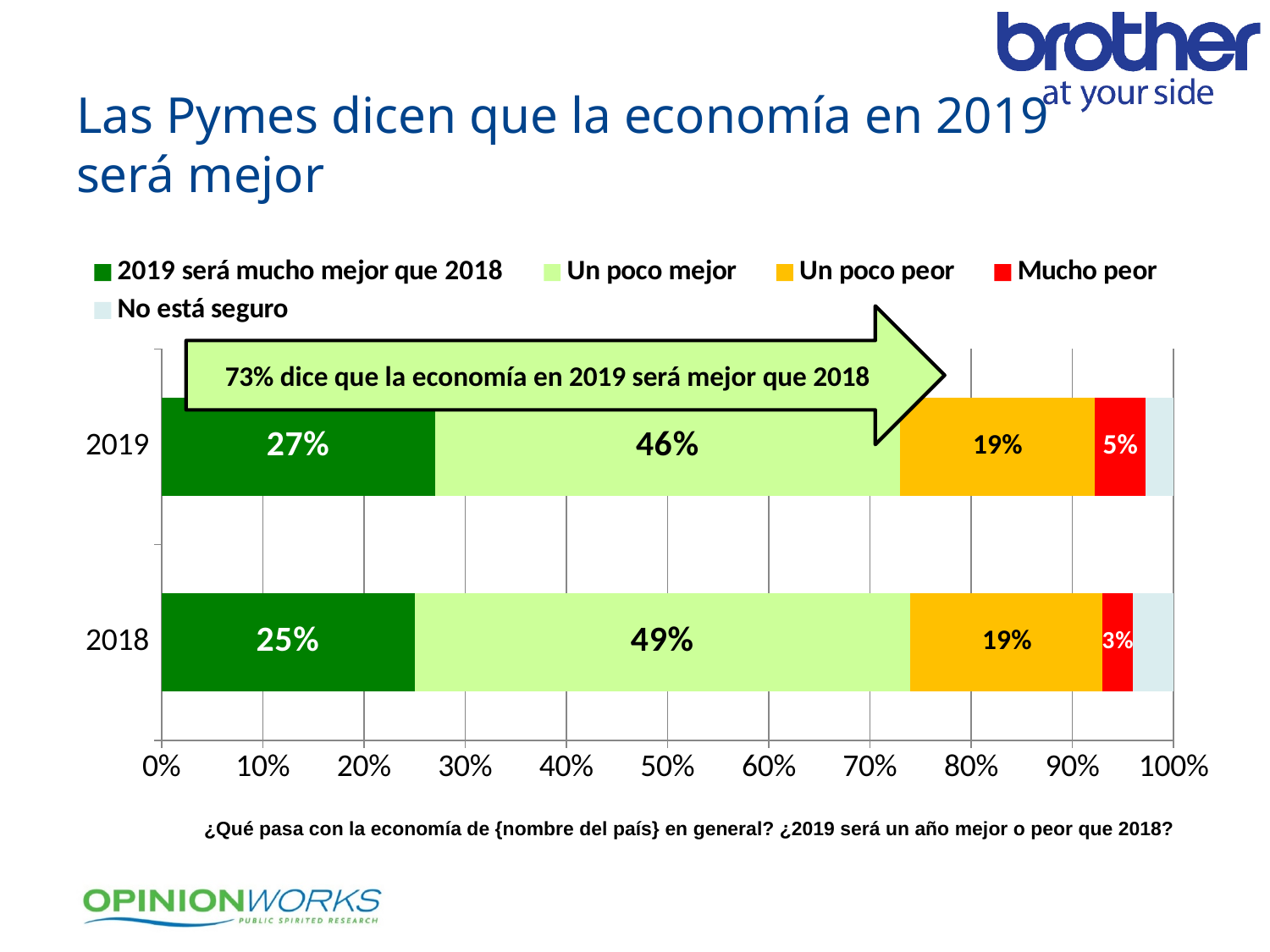
What is the value for 'Un poco peor' in the 2018 bar? 19% What does the callout arrow on the chart say? 73% dice que la economía en 2019 será mejor que 2018 What is the difference between the 'Un poco mejor' values for 2018 and 2019? 3% What is the value for 'Un poco mejor' in the 2018 bar? 49% What is the value for 'Mucho peor' in the 2019 bar? 5% Which series has the largest value in the 2019 bar? Un poco mejor How many series does the legend list? 5 What is the value for '2019 será mucho mejor que 2018' in the 2019 bar? 27% Which labelled series has the smallest value in the 2018 bar? Mucho peor How many categories (years) are plotted on the chart? 2 Which year has the larger value for '2019 será mucho mejor que 2018', 2019 or 2018? 2019 What kind of chart is shown on the slide? stacked bar chart